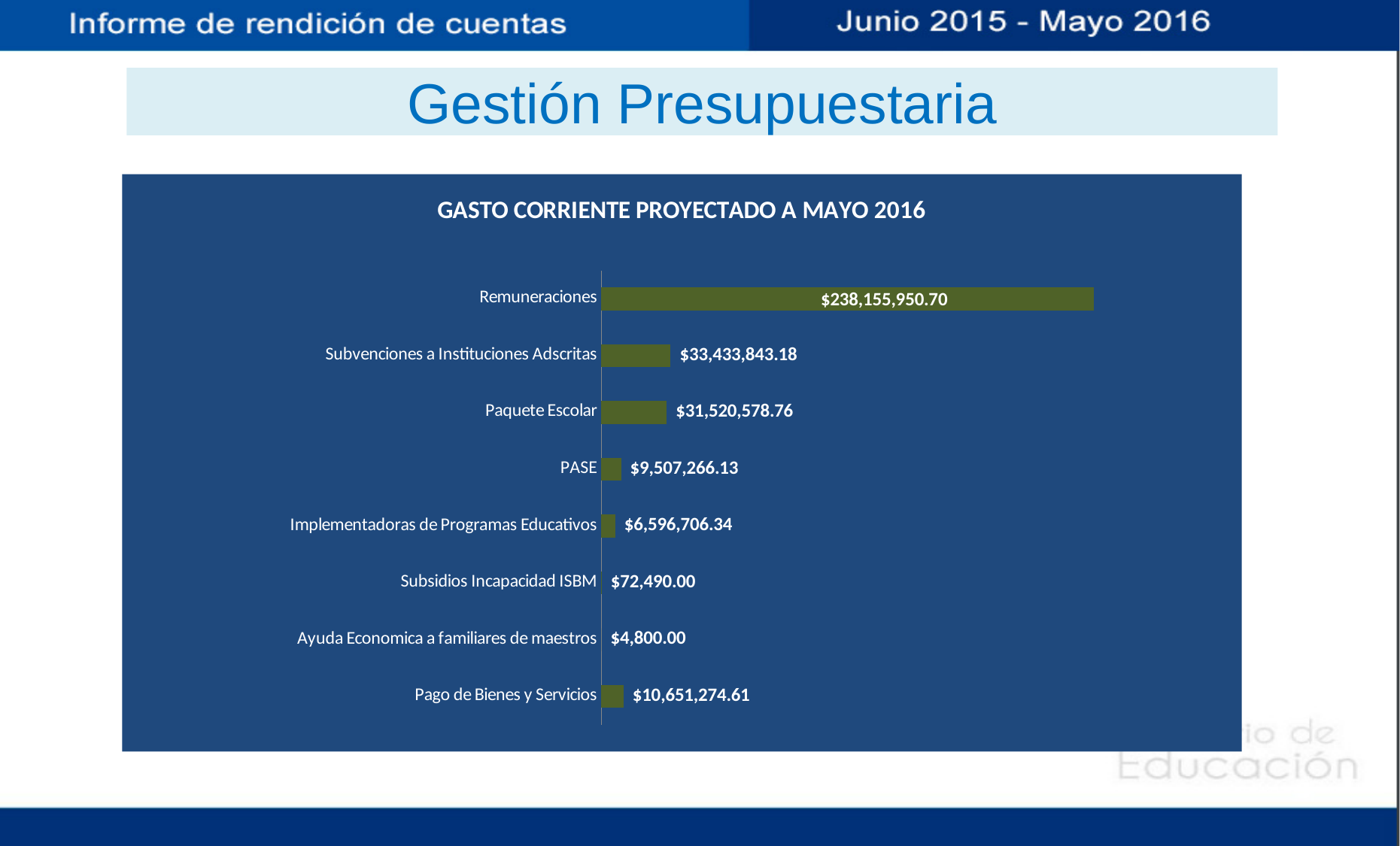
Which category has the lowest projected expense? Ayuda Economica a familiares de maestros What is the value for Subsidios Incapacidad ISBM? $72,490.00 How many categories are shown in the chart? 8 What is the title of the chart? GASTO CORRIENTE PROYECTADO A MAYO 2016 Which category has the highest projected expense? Remuneraciones What is the value shown for Paquete Escolar? $31,520,578.76 What is the difference between PASE and Implementadoras de Programas Educativos? $2,910,559.79 Which is larger, Pago de Bienes y Servicios or PASE? Pago de Bienes y Servicios What is the value for Pago de Bienes y Servicios? $10,651,274.61 What type of chart is shown on the slide? Bar chart What is the projected value for Remuneraciones? $238,155,950.70 What is the difference between Subvenciones a Instituciones Adscritas and Paquete Escolar? $1,913,264.42